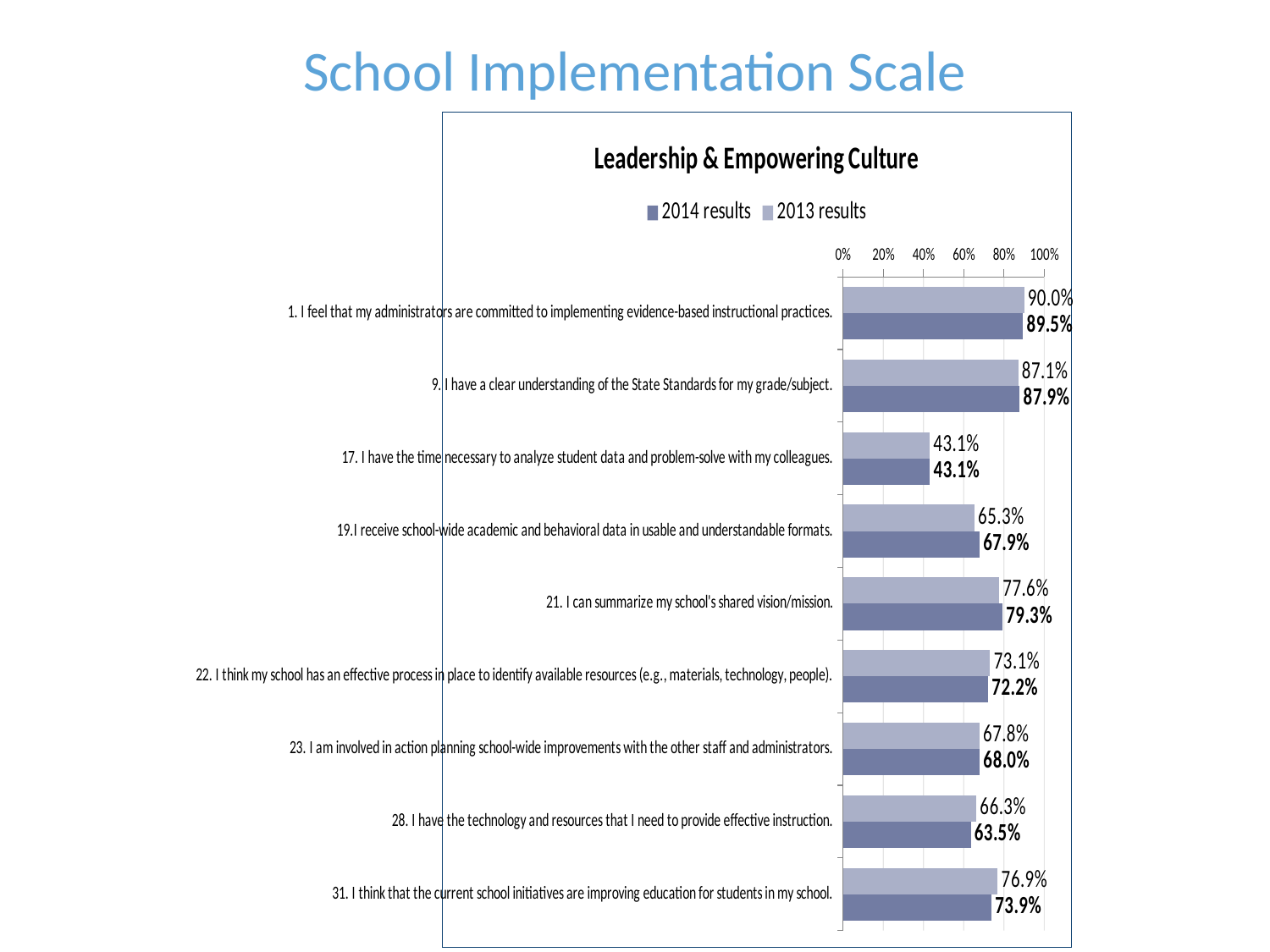
What is the title of the chart? Leadership & Empowering Culture How many survey items (categories) are plotted in the chart? 9 How many series does the legend list? 2 Which item has the highest 2013 result? 1. I feel that my administrators are committed to implementing evidence-based instructional practices. Is the 2014 result for item 21, 'I can summarize my school's shared vision/mission', greater or less than 60%? greater What is the 2013 result for item 17, 'I have the time necessary to analyze student data and problem-solve with my colleagues'? 43.1% Which item has the lowest 2014 result? 17. I have the time necessary to analyze student data and problem-solve with my colleagues. What kind of chart is shown on the slide? Bar chart For item 19, 'I receive school-wide academic and behavioral data in usable and understandable formats', which is larger: the 2013 result or the 2014 result? 2014 result What is the 2014 result for item 28, 'I have the technology and resources that I need to provide effective instruction'? 63.5% What is the difference between the 2013 and 2014 results for item 31, 'I think that the current school initiatives are improving education for students in my school'? 3.0% What is the 2014 result for item 1, 'I feel that my administrators are committed to implementing evidence-based instructional practices'? 89.5%